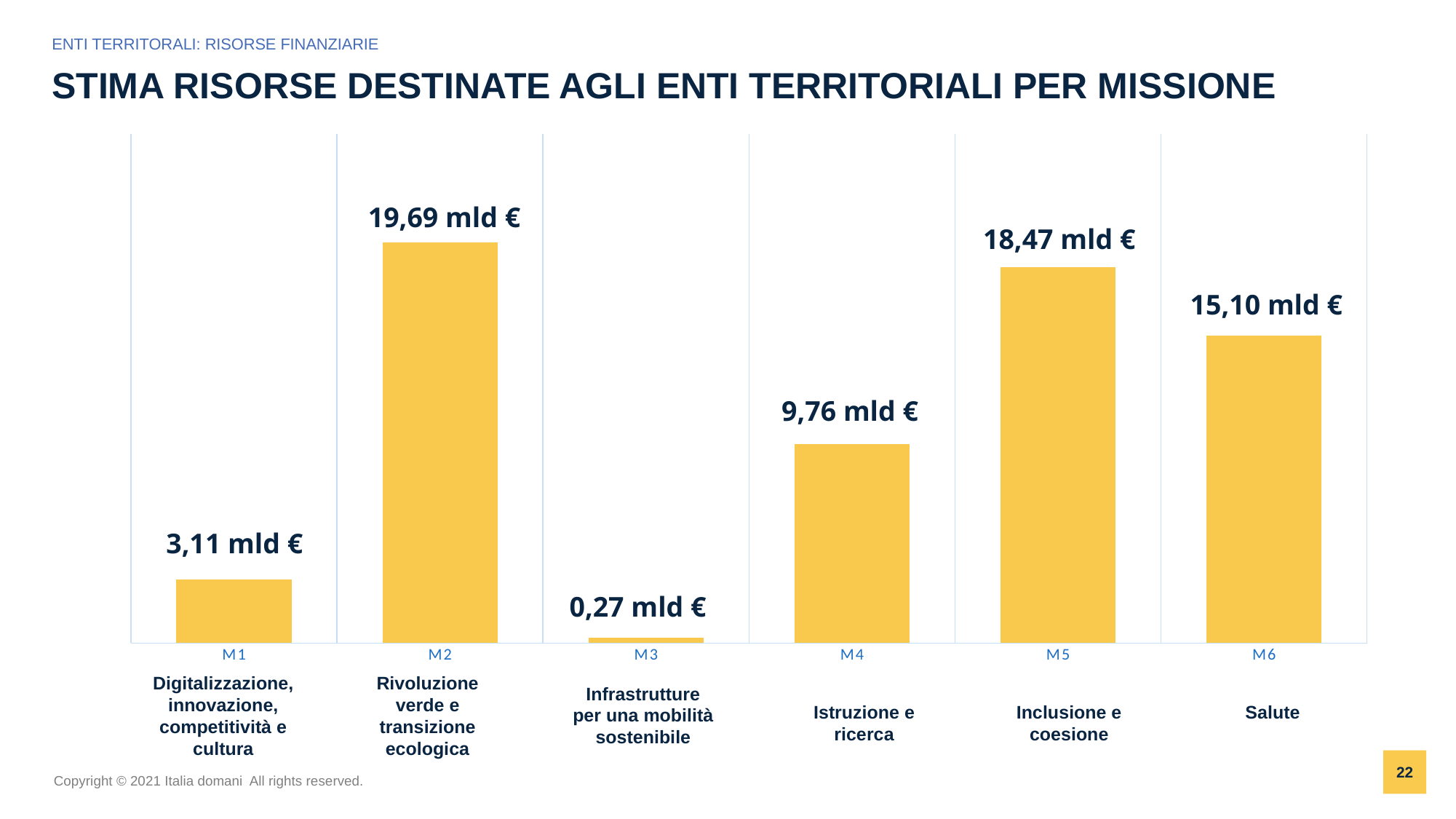
What is the value for M3 (Infrastrutture per una mobilità sostenibile)? 0,27 mld € What kind of chart is shown on the slide? Bar chart What is the difference between the values for M2 and M5? 1,22 mld € What is the value for M4 (Istruzione e ricerca)? 9,76 mld € What is the title of the chart? STIMA RISORSE DESTINATE AGLI ENTI TERRITORIALI PER MISSIONE What is the value for M2 (Rivoluzione verde e transizione ecologica)? 19,69 mld € Which mission has the highest value? M2 (Rivoluzione verde e transizione ecologica) Which is larger, the value for M4 or the value for M1? M4 What is the difference between the values for M5 and M6? 3,37 mld € What is the value for M6 (Salute)? 15,10 mld € How many missions are shown in the chart? 6 Which mission has the lowest value? M3 (Infrastrutture per una mobilità sostenibile)